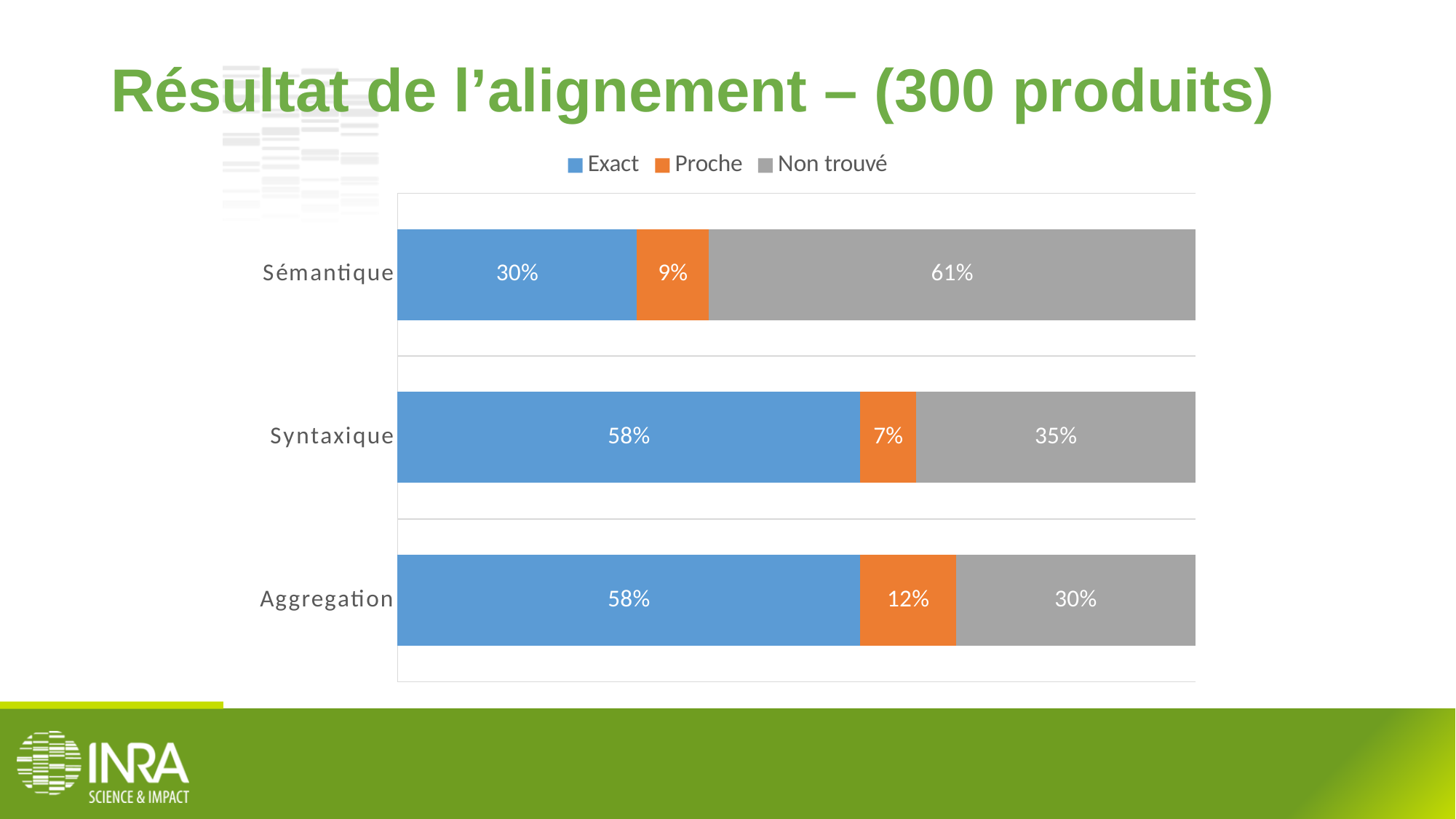
Which category has the lowest Proche value? Syntaxique Which category has the highest Non trouvé value? Sémantique What is the Proche value for Aggregation? 12% What is the Non trouvé value for Syntaxique? 35% What is the difference between the Non trouvé values for Sémantique and Aggregation? 31% How many series does the legend list? 3 Which is larger, the Proche value for Sémantique or the Proche value for Aggregation? Aggregation What is the Exact value for Sémantique? 30% Which series is shown in orange in the legend? Proche How many categories are shown on the chart? 3 What kind of chart is shown on the slide? Stacked bar chart What is the total of the stacked bar for Syntaxique? 100%